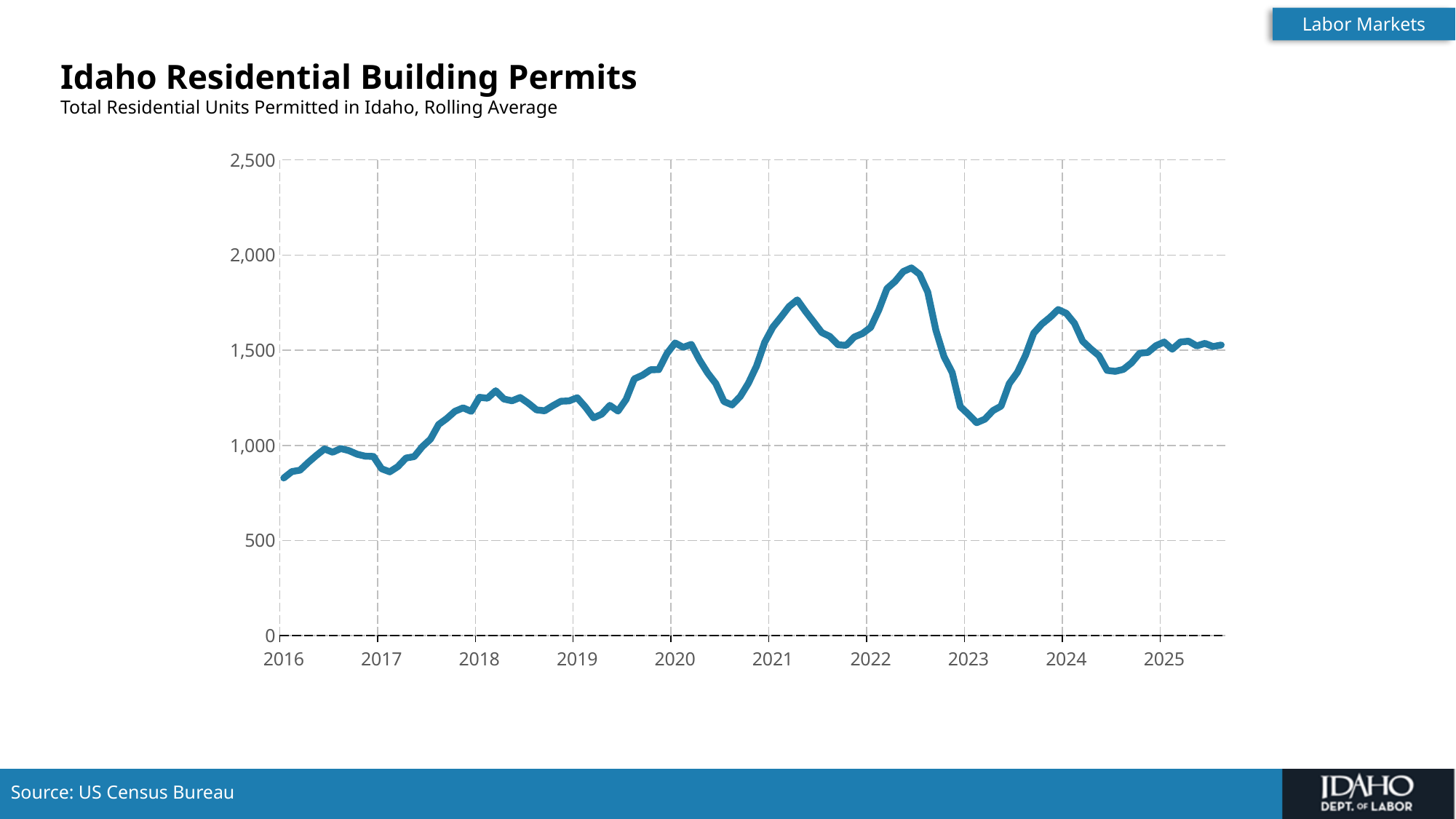
What kind of chart is shown on the slide? line chart Is the value at the start of 2024 greater or less than 1,500? greater What is the title of the chart? Idaho Residential Building Permits Is the highest point on the line, reached in 2022, greater or less than 2,000? less What source is cited for the chart data? US Census Bureau In which year does the line reach its highest peak? 2022 Is the value at the start of 2018 greater or less than 1,000? greater How many year labels are shown on the x axis? 10 Does the line generally rise or fall between 2016 and 2018? rise